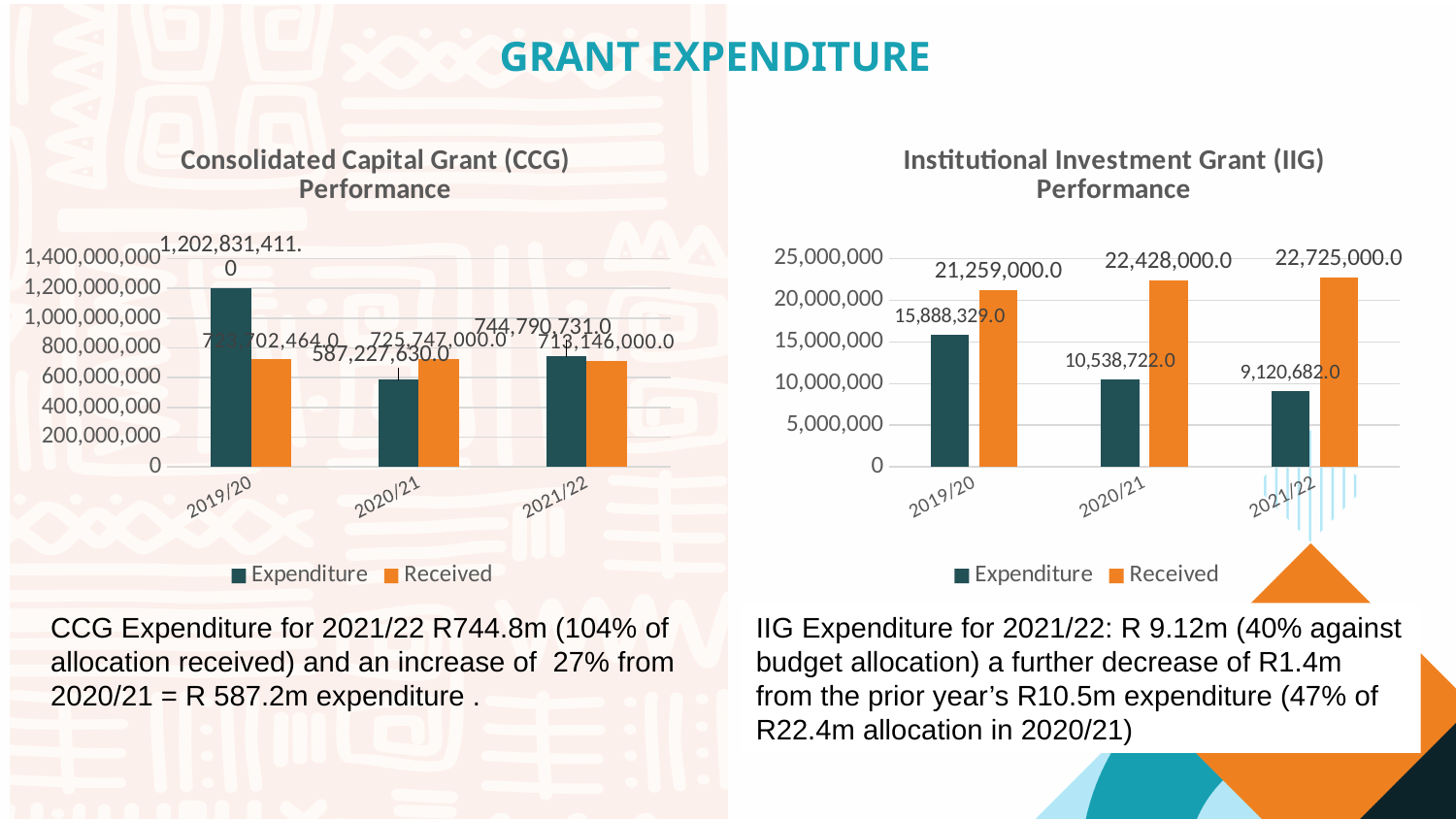
In the Institutional Investment Grant (IIG) Performance chart, what is the difference between Received and Expenditure for 2021/22? 13,604,318.0 In the Consolidated Capital Grant (CCG) Performance chart, for 2021/22, which is larger: Expenditure or Received? Expenditure In the Consolidated Capital Grant (CCG) Performance chart, what is the Expenditure value for 2020/21? 587,227,630.0 In the Consolidated Capital Grant (CCG) Performance chart, which year has the highest Expenditure? 2019/20 In the Consolidated Capital Grant (CCG) Performance chart, what is the Received value for 2021/22? 713,146,000.0 In the Institutional Investment Grant (IIG) Performance chart, which year has the lowest Expenditure? 2021/22 In the Consolidated Capital Grant (CCG) Performance chart, what is the Expenditure value for 2021/22? 744,790,731.0 In the Institutional Investment Grant (IIG) Performance chart, what is the Expenditure value for 2021/22? 9,120,682.0 How many series does the legend of the Institutional Investment Grant (IIG) Performance chart list? 2 In the Institutional Investment Grant (IIG) Performance chart, what is the Received value for 2020/21? 22,428,000.0 In the Institutional Investment Grant (IIG) Performance chart, does Expenditure rise or fall from 2019/20 to 2021/22? Fall What type of chart is the Consolidated Capital Grant (CCG) Performance chart? Bar chart